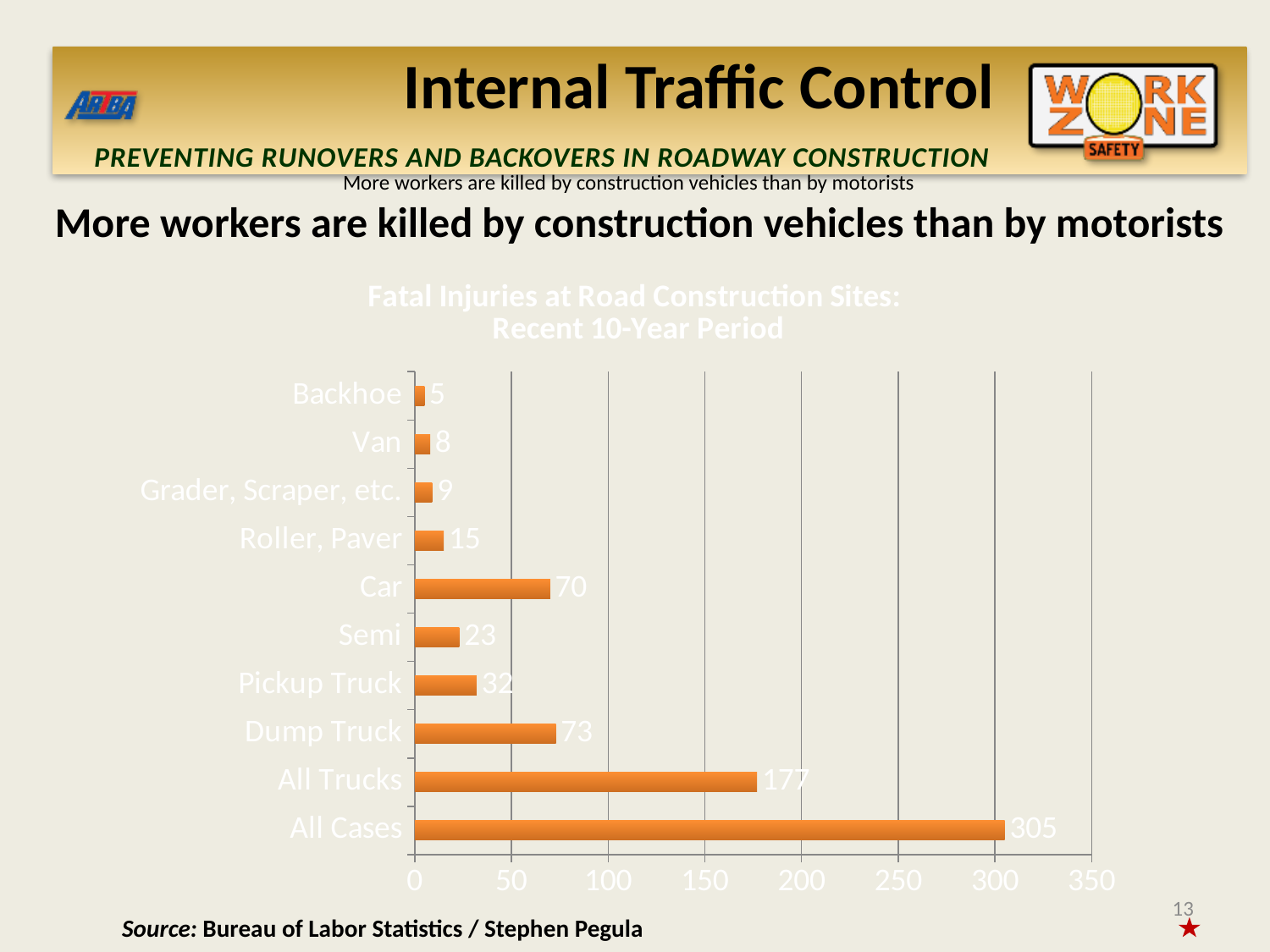
Which category has the highest value? All Cases How many categories are shown in the chart? 10 What is the difference between All Cases and All Trucks? 128 What kind of chart is this? bar chart What is the value for All Trucks? 177 Which is larger, Pickup Truck or Semi? Pickup Truck What is the title of the chart? Fatal Injuries at Road Construction Sites: Recent 10-Year Period Is the value for All Trucks greater or less than 150? greater What is the value for Dump Truck? 73 What is the value for Car? 70 Which category has the lowest value? Backhoe What is the difference between Dump Truck and Car? 3